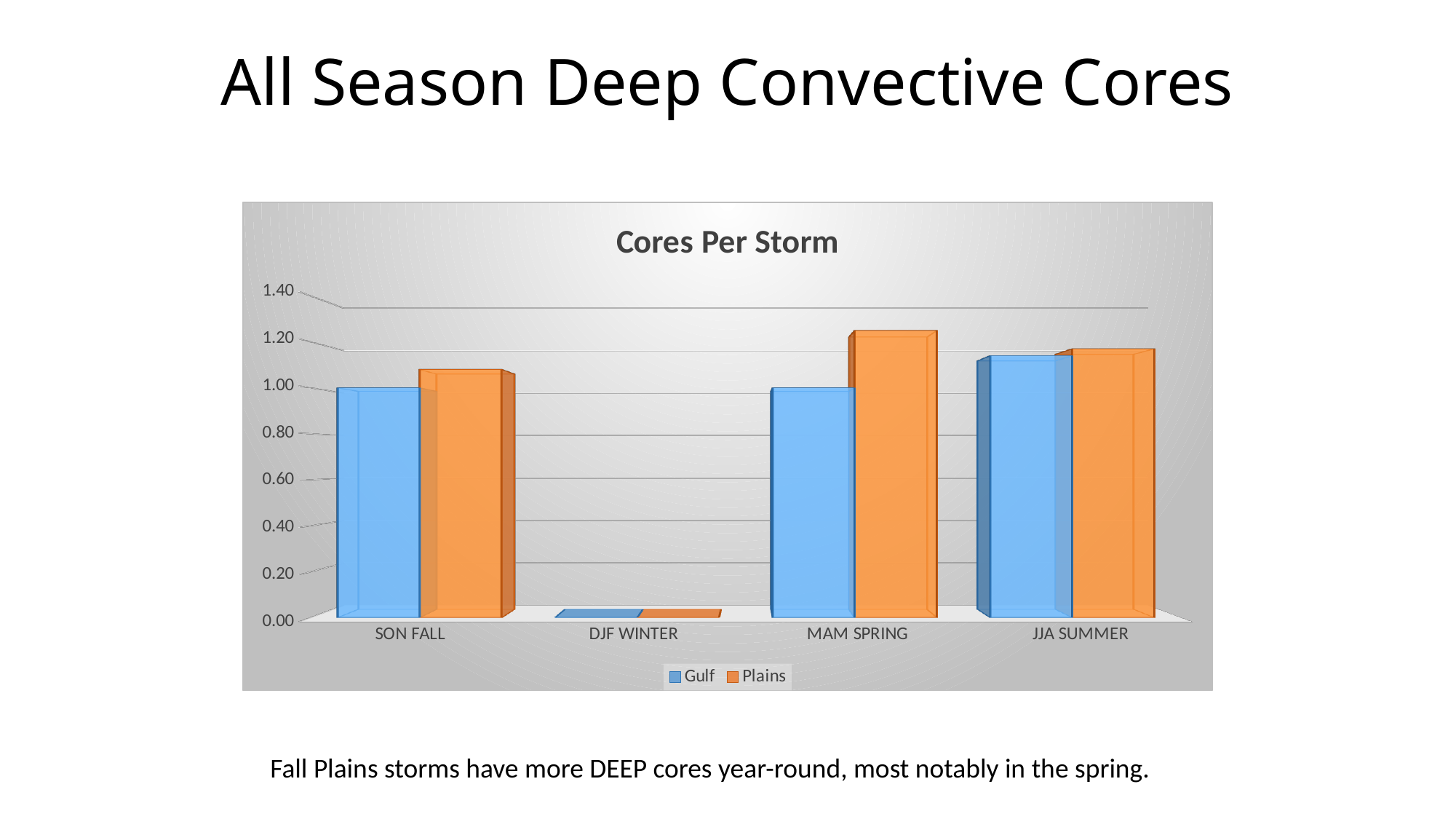
Is the Gulf value for DJF WINTER greater or less than 0.20? less Is the Plains value for MAM SPRING greater or less than 1.00? greater Which season has the highest Gulf value? JJA SUMMER Which season has the lowest Gulf value? DJF WINTER What is the title of the chart? Cores Per Storm How many series does the legend list? 2 Which season has the highest Plains value? MAM SPRING Is the Gulf value for JJA SUMMER greater or less than 1.00? greater How many season categories are shown on the x axis? 4 What kind of chart is shown on the slide? Bar chart For MAM SPRING, which is larger, the Gulf value or the Plains value? Plains Which series are listed in the legend? Gulf and Plains